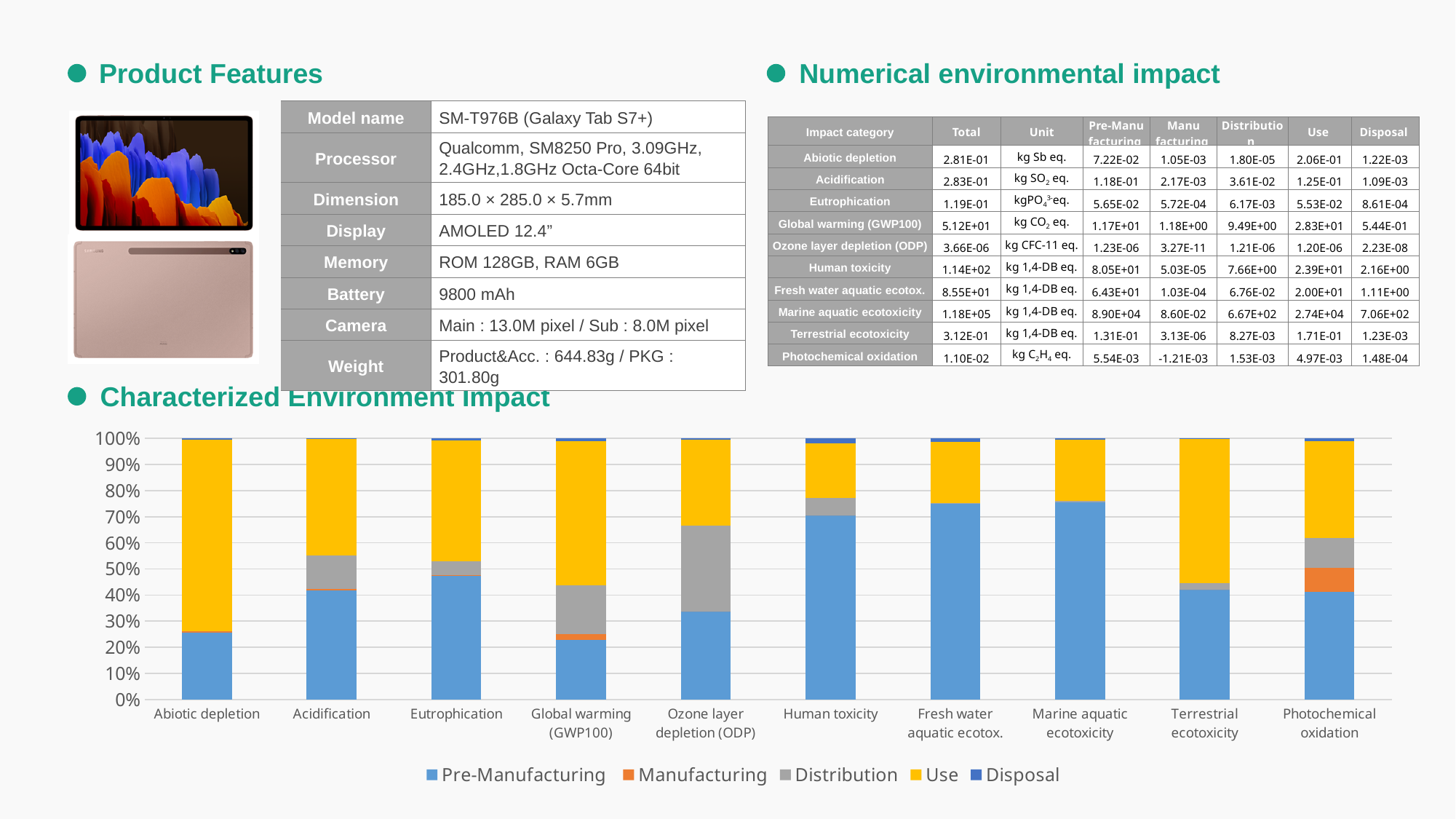
In the Characterized Environment Impact chart, is the Pre-Manufacturing share for Ozone layer depletion (ODP) greater or less than 40%? less In the Characterized Environment Impact chart, which colour represents the Use series? Yellow What kind of chart is shown under "Characterized Environment Impact"? Stacked bar chart In the Characterized Environment Impact chart, is the Pre-Manufacturing share for Human toxicity greater or less than 60%? greater In the Characterized Environment Impact chart, is the Pre-Manufacturing share for Abiotic depletion greater or less than 30%? less In the Characterized Environment Impact chart, which has the larger Pre-Manufacturing share: Marine aquatic ecotoxicity or Abiotic depletion? Marine aquatic ecotoxicity How many impact categories are plotted along the x axis of the Characterized Environment Impact chart? 10 What are the legend entries of the Characterized Environment Impact chart? Pre-Manufacturing, Manufacturing, Distribution, Use, Disposal How many series does the legend of the Characterized Environment Impact chart list? 5 In the Characterized Environment Impact chart, which has the larger Manufacturing share: Photochemical oxidation or Acidification? Photochemical oxidation